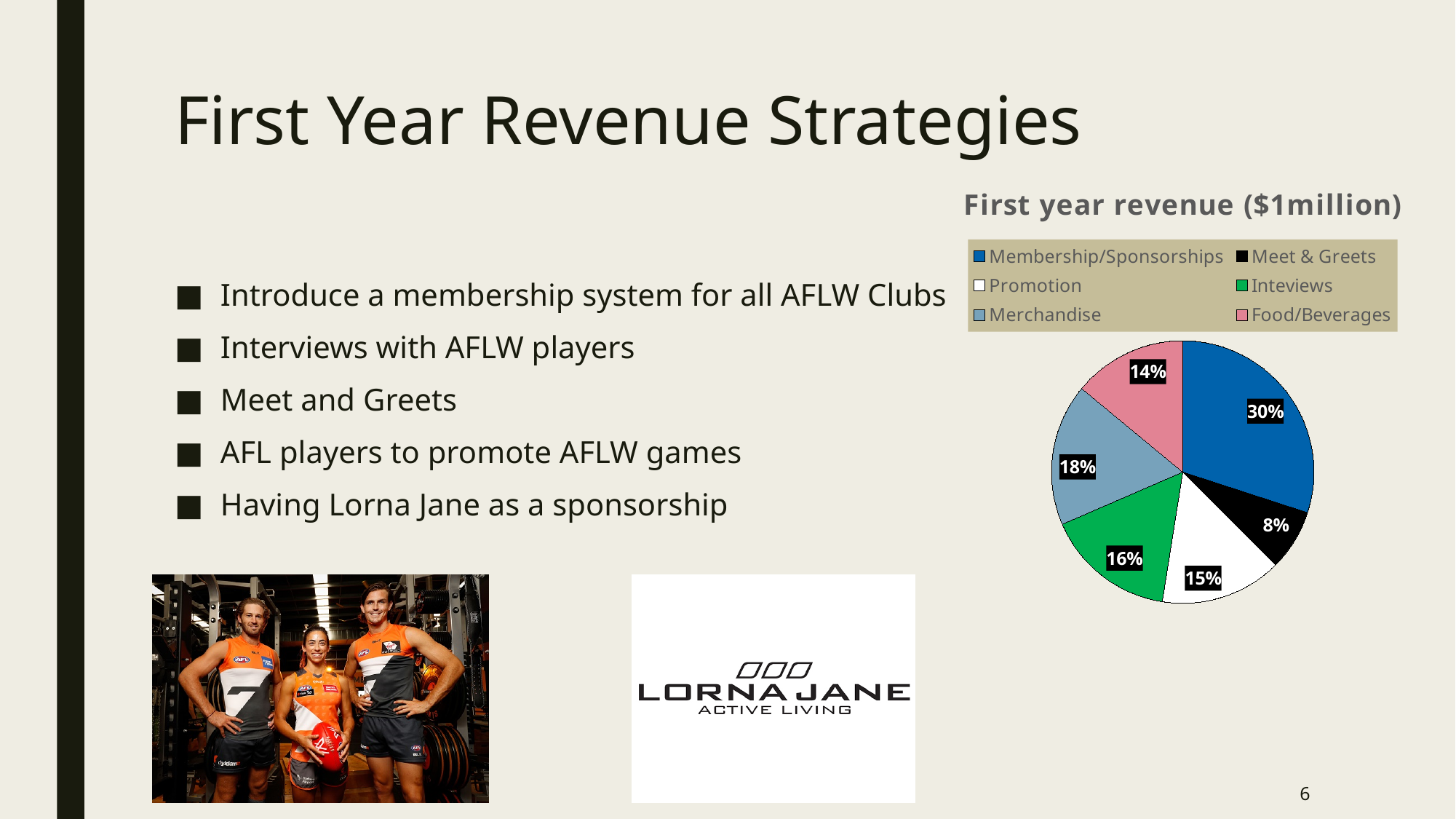
How many categories does the legend of the pie chart list? 6 What type of chart is shown on the slide? pie chart What is the title of the chart? First year revenue ($1million) What share of first year revenue comes from Membership/Sponsorships? 30% Which has a larger share of first year revenue, Interviews or Promotion? Interviews Which category has the largest share of first year revenue? Membership/Sponsorships What share of first year revenue comes from Food/Beverages? 14% Which category has the smallest share of first year revenue? Meet & Greets What share of first year revenue comes from Merchandise? 18% What is the difference in percentage points between the Membership/Sponsorships share and the Merchandise share? 12